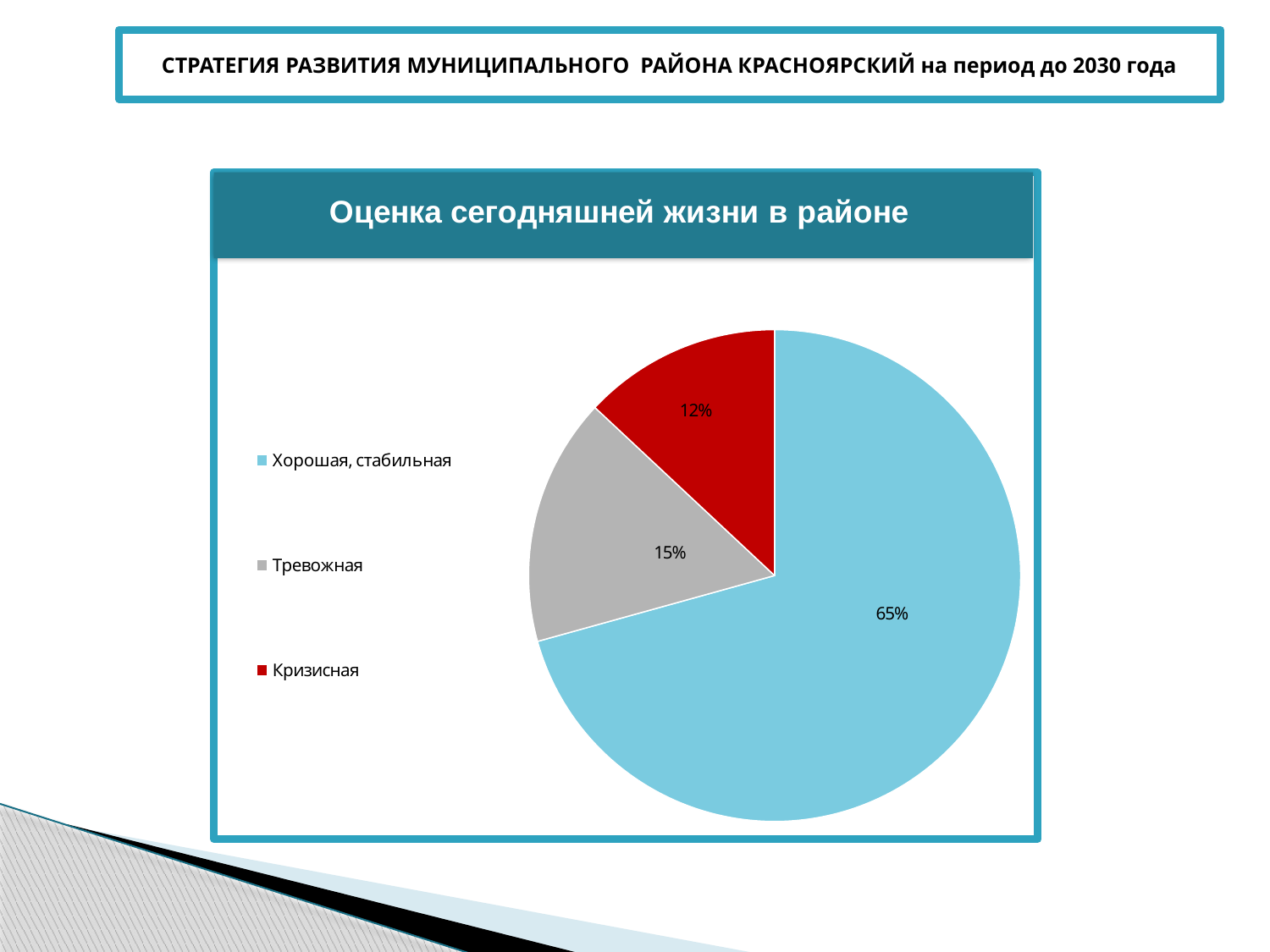
What is the difference between the shares for "Тревожная" and "Кризисная"? 3% Which is larger, the share for "Тревожная" or the share for "Кризисная"? Тревожная How many categories does the pie chart show? 3 What colour is the slice for "Кризисная"? red What share of the pie is labelled "Хорошая, стабильная"? 65% What is the difference between the shares for "Хорошая, стабильная" and "Тревожная"? 50% Which category has the largest slice of the pie? Хорошая, стабильная What share of the pie is labelled "Тревожная"? 15% What share of the pie is labelled "Кризисная"? 12% What is the title of the chart? Оценка сегодняшней жизни в районе Which category has the smallest slice of the pie? Кризисная What kind of chart is shown on the slide? pie chart